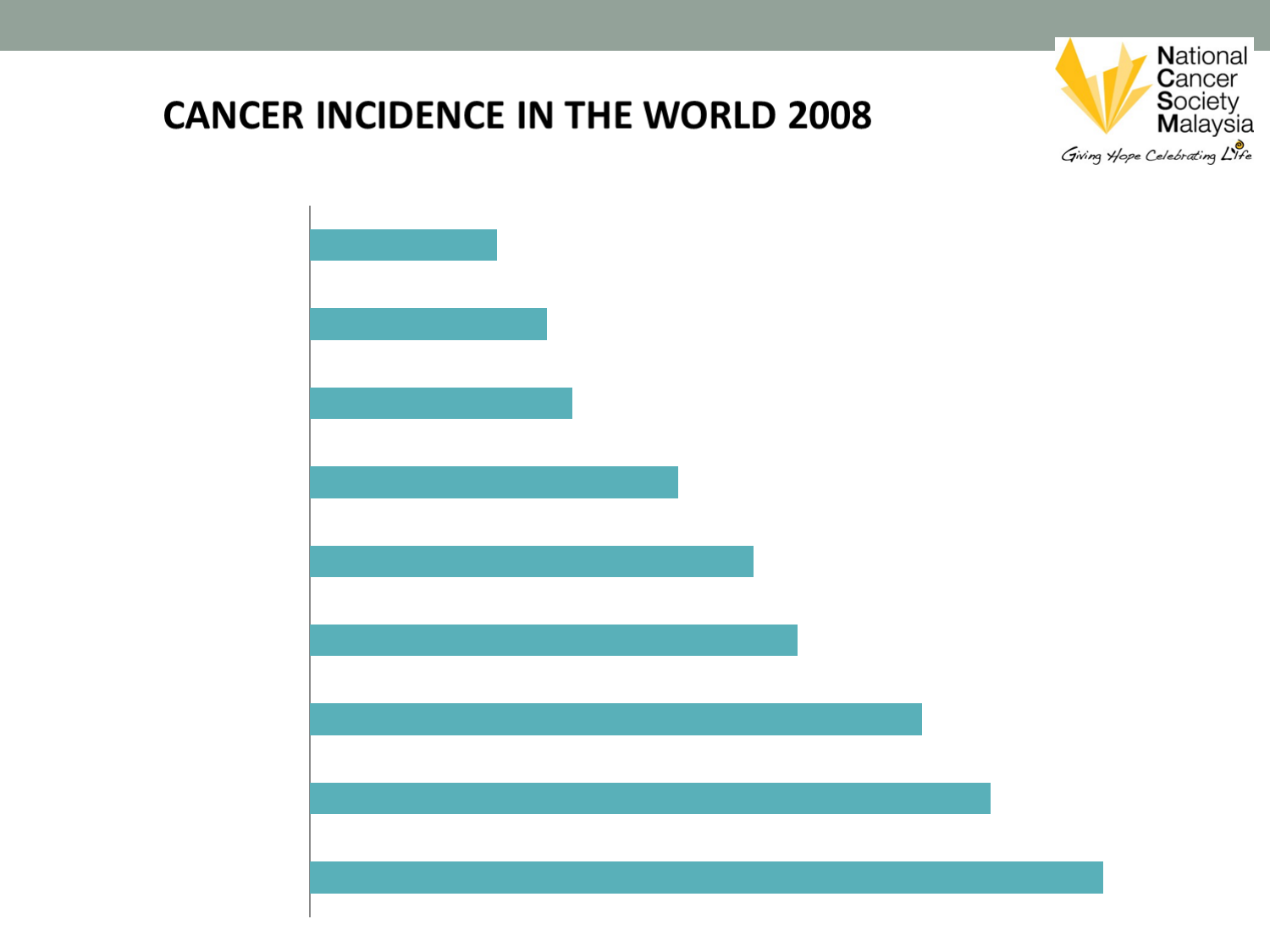
How many bars does the chart contain? 9 Do the bar lengths increase or decrease going from the top bar to the bottom bar? increase Which bar is the longest: the top bar or the bottom bar? the bottom bar What is the title of the slide's chart? CANCER INCIDENCE IN THE WORLD 2008 Which is longer, the second bar from the top or the second bar from the bottom? the second bar from the bottom What kind of chart is shown on the slide? bar chart Which bar is the shortest: the top bar or the bottom bar? the top bar Are the bars in the chart horizontal or vertical? horizontal